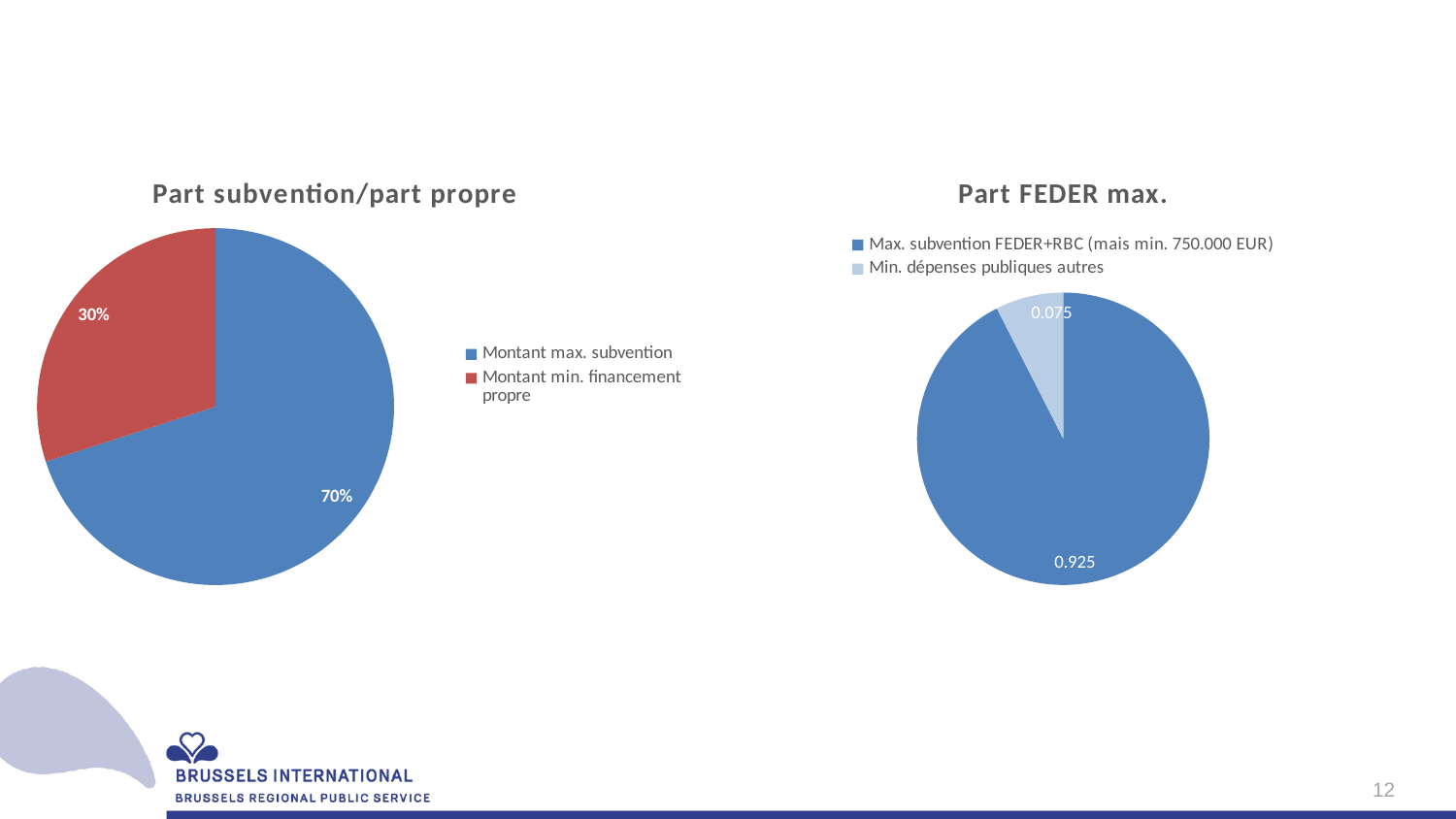
In the 'Part FEDER max.' chart, what is the difference between the two slices? 0.85 In the 'Part FEDER max.' chart, what is the value for 'Max. subvention FEDER+RBC (mais min. 750.000 EUR)'? 0.925 In the 'Part subvention/part propre' chart, what is the difference between the two slices? 40% In the 'Part subvention/part propre' chart, what is the value for 'Montant max. subvention'? 70% In the 'Part subvention/part propre' chart, which slice is the largest? Montant max. subvention In the 'Part subvention/part propre' chart, what is the value for 'Montant min. financement propre'? 30% In the 'Part subvention/part propre' chart, what colour is the 'Montant min. financement propre' slice? Red What kind of chart is 'Part subvention/part propre'? Pie chart In the 'Part FEDER max.' chart, which slice is the smallest? Min. dépenses publiques autres How many slices does the 'Part FEDER max.' pie chart have? 2 How many entries does the legend of the 'Part subvention/part propre' chart list? 2 In the 'Part FEDER max.' chart, what is the value for 'Min. dépenses publiques autres'? 0.075